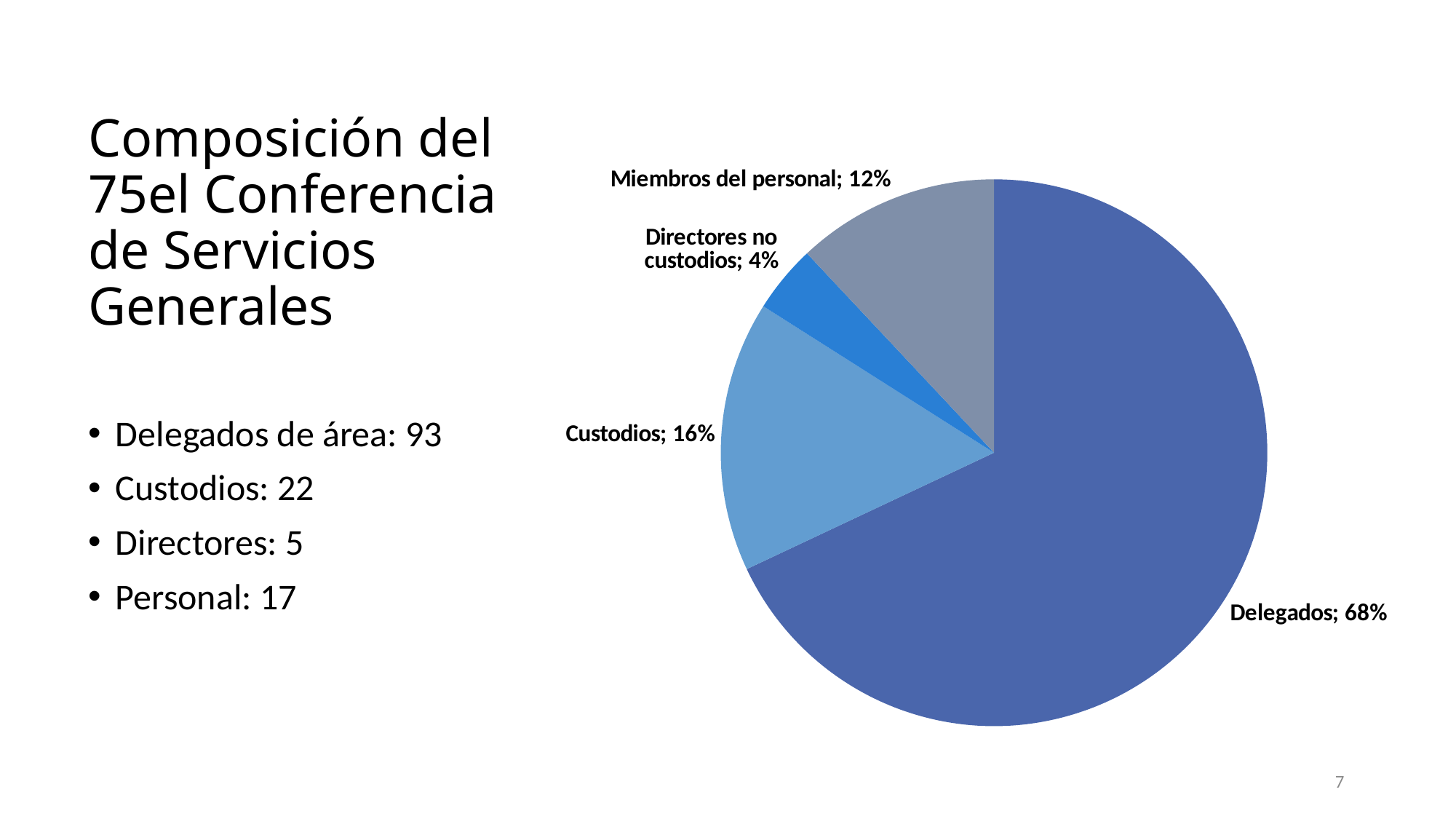
Which slice of the pie is the smallest? Directores no custodios What is the difference in percentage points between the Delegados slice and the Custodios slice? 52 What percentage does the Delegados slice represent? 68% What is the title of the slide containing the pie chart? Composición del 75el Conferencia de Servicios Generales What percentage does the Miembros del personal slice represent? 12% What kind of chart is shown on the slide? pie chart What percentage does the Custodios slice represent? 16% Which slice is larger, Custodios or Miembros del personal? Custodios Which slice of the pie is the largest? Delegados What percentage does the Directores no custodios slice represent? 4% What is the combined percentage of the Custodios and Miembros del personal slices? 28% How many slices does the pie chart have? 4